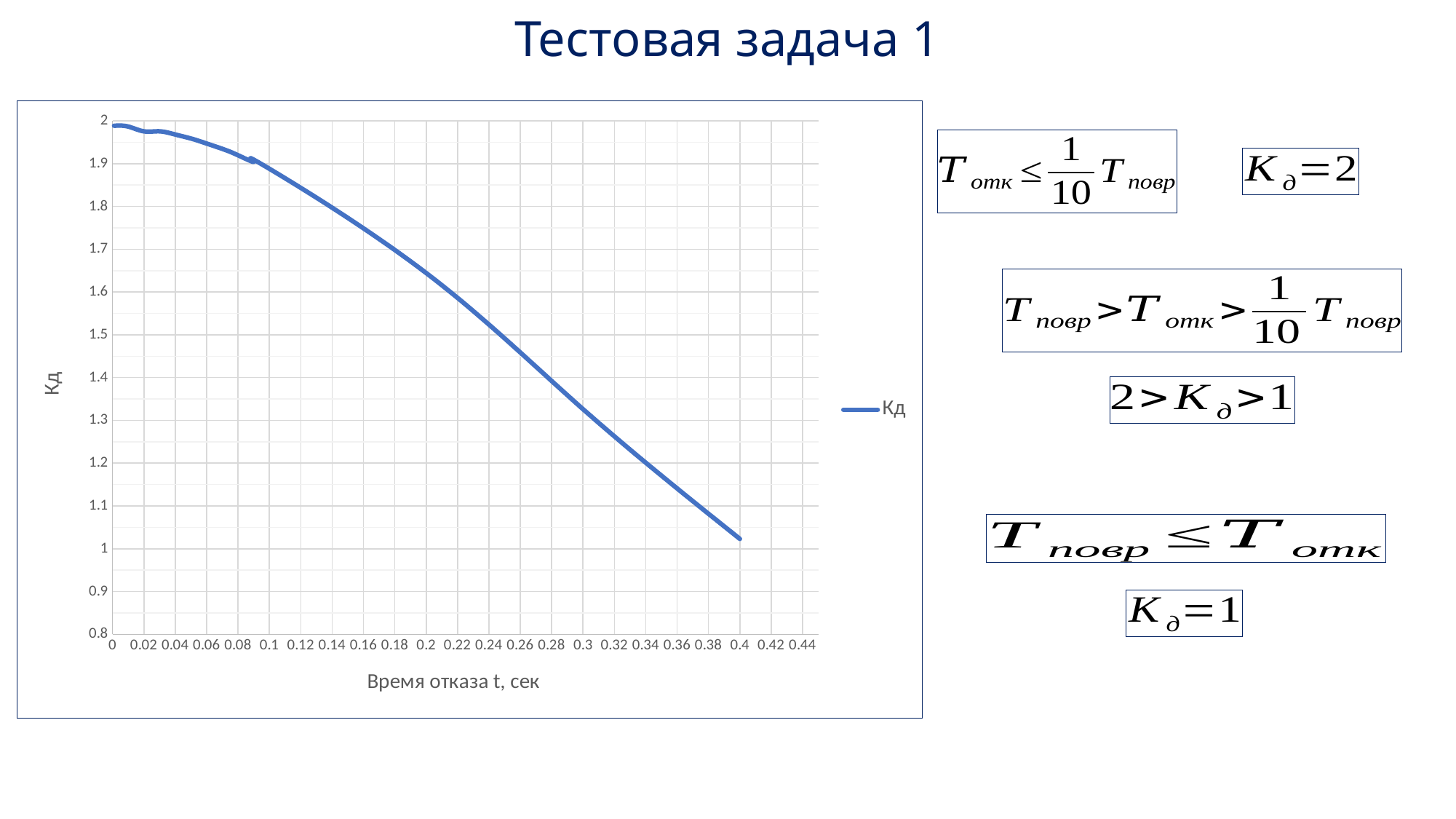
Is the value of Кд at t = 0 greater or less than 1.9? greater Which is larger, the value of Кд at t = 0.1 or at t = 0.3? t = 0.1 Is the value of Кд at t = 0.3 greater or less than 1.4? less Do the values of Кд rise or fall as the failure time t increases along the x axis? fall Is the value of Кд at t = 0.2 greater or less than 1.6? greater What kind of chart is shown on the slide? line chart What is the title of the x axis of the chart? Время отказа t, сек At which end of the x axis, t = 0 or t = 0.4, does the Кд line reach its lowest value? t = 0.4 What is the name of the series shown in the chart legend? Кд How many series does the chart legend list? 1